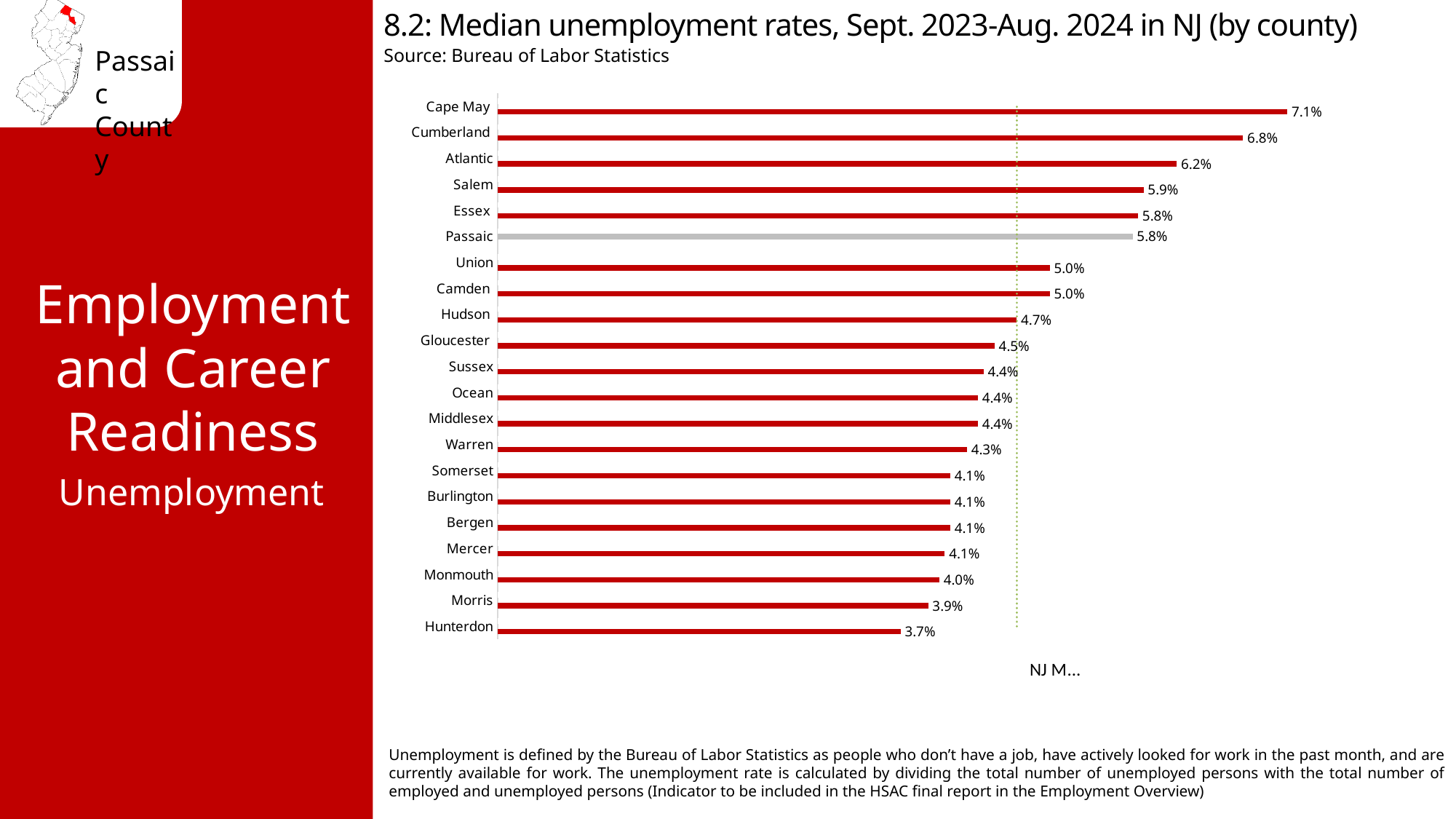
Which county's bar is shown in grey rather than red? Passaic What is the median unemployment rate for Hudson county? 4.7% Which county has the lowest median unemployment rate? Hunterdon Which county has the highest median unemployment rate? Cape May What kind of chart is shown on the slide? Bar chart Which county has a higher median unemployment rate, Atlantic or Union? Atlantic Which county has a higher median unemployment rate, Morris or Warren? Warren How many counties are shown in the chart? 21 What is the difference between the median unemployment rates of Cape May and Hunterdon? 3.4% What is the difference between the median unemployment rates of Cumberland and Passaic? 1.0% What is the median unemployment rate for Cape May county? 7.1% What is the median unemployment rate for Passaic county? 5.8%